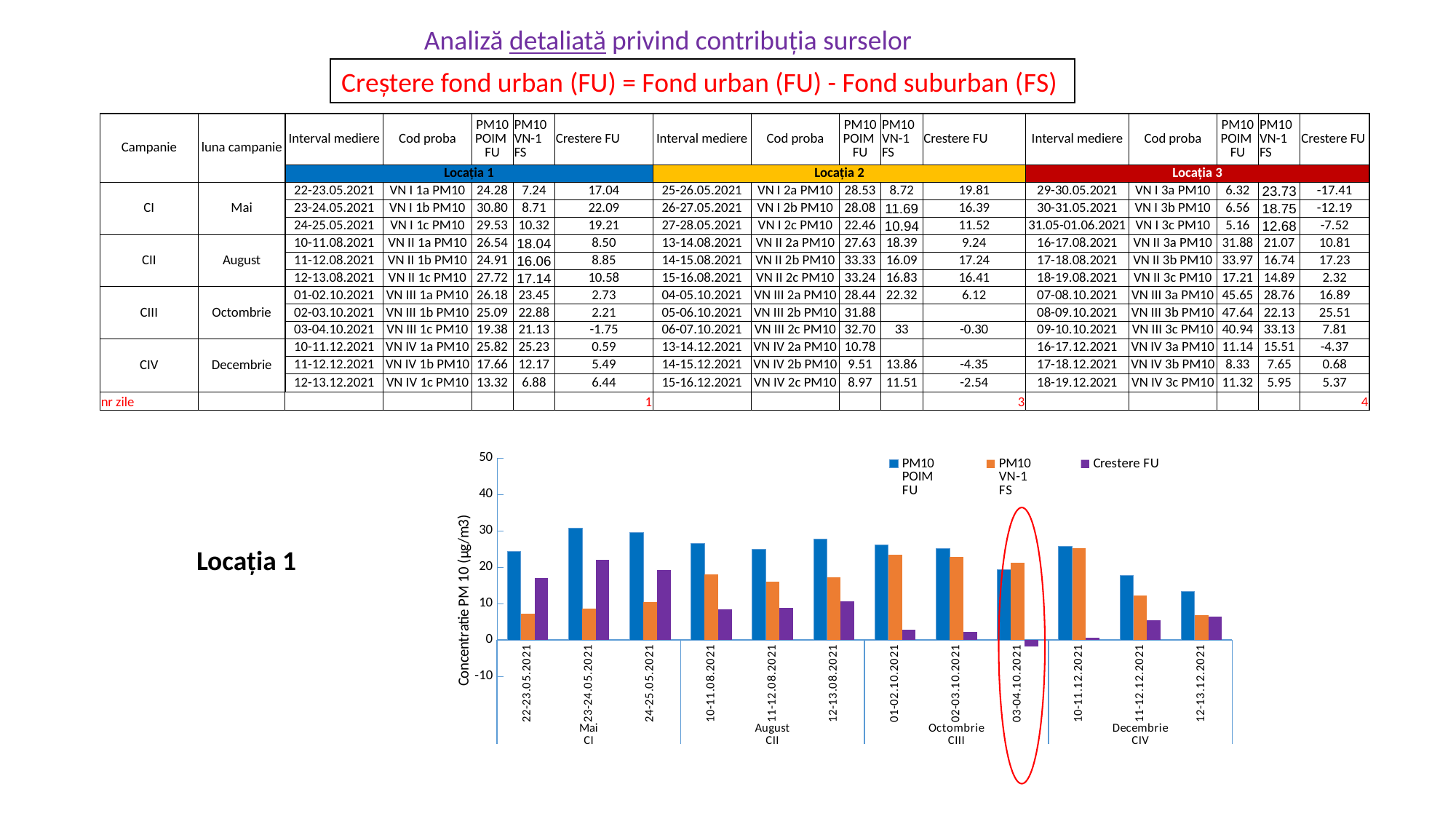
In the Locația 1 chart, is the PM10 POIM FU value for 22-23.05.2021 greater or less than 20? greater In the Locația 1 chart, is the PM10 VN-1 FS value for 22-23.05.2021 greater or less than 10? less In the Locația 1 chart, which date has the highest Crestere FU value? 23-24.05.2021 How many series does the legend of the Locația 1 chart list? 3 According to the table, what is the Crestere FU value for Locația 1 on 22-23.05.2021? 17.04 In the Locația 1 chart, which date has the lowest Crestere FU value? 03-04.10.2021 In the Locația 1 chart, do the PM10 POIM FU values rise or fall across the three December (CIV) dates? fall In the Locația 1 chart, is the PM10 VN-1 FS value for 12-13.12.2021 greater or less than 10? less In the Locația 1 chart, for 03-04.10.2021, which is larger: PM10 POIM FU or PM10 VN-1 FS? PM10 VN-1 FS How many sampling dates are shown on the x axis of the Locația 1 chart? 12 Which date on the Locația 1 chart is circled in red? 03-04.10.2021 What kind of chart is shown for Locația 1? bar chart